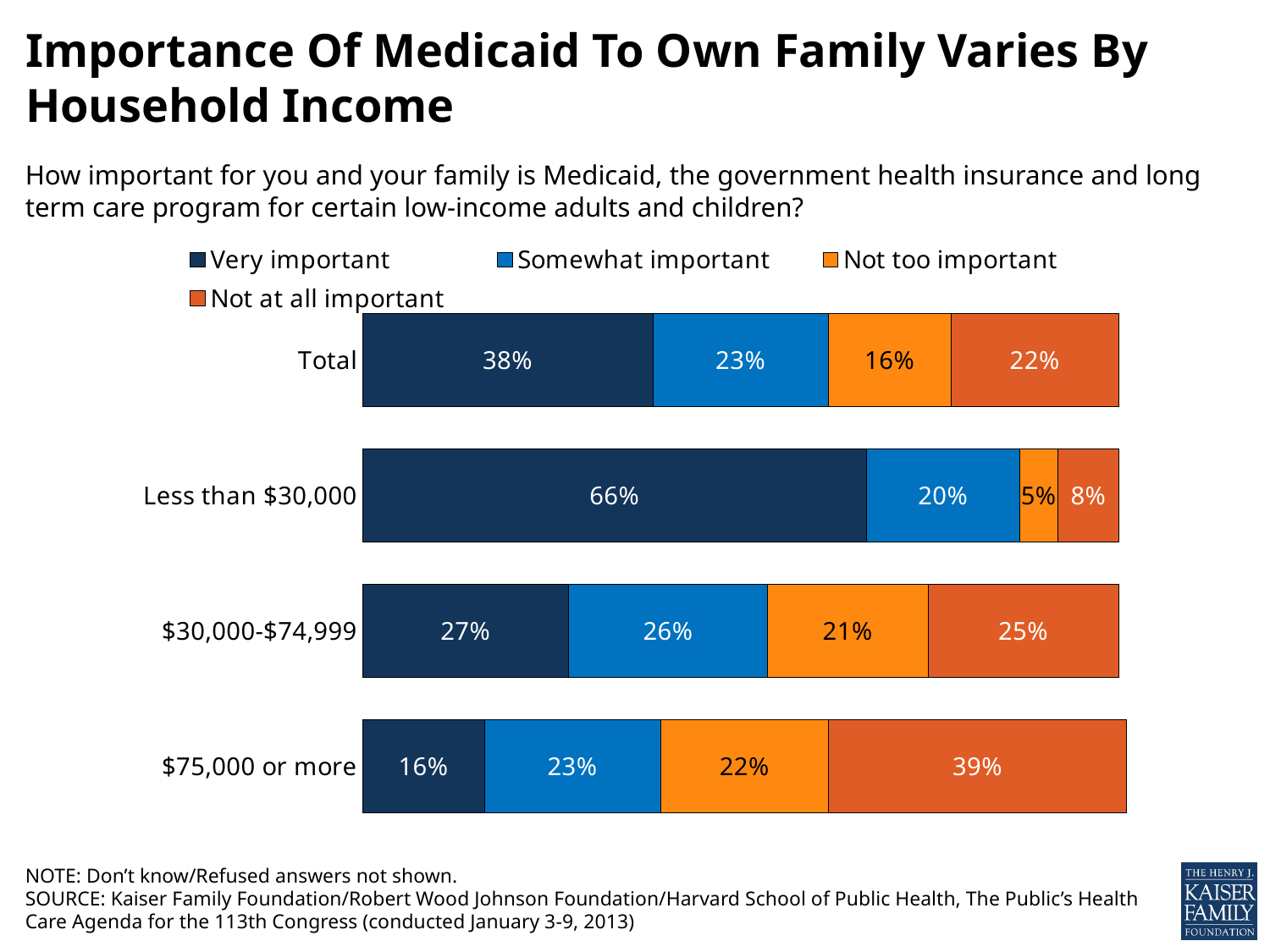
What percentage of those earning $75,000 or more say Medicaid is not at all important? 39% What is the difference between the very important shares for the less than $30,000 group and the $75,000 or more group? 50 percentage points Which is larger: the not at all important share for $75,000 or more, or for $30,000-$74,999? $75,000 or more What percentage of the $30,000-$74,999 group says Medicaid is not too important? 21% How many income categories (bars) are shown in the chart? 4 What kind of chart is shown on the slide? Stacked bar chart Which income group has the lowest share saying Medicaid is not at all important? Less than $30,000 How many series does the legend list? 4 What is the combined share of very important and somewhat important for the less than $30,000 group? 86% Which income group has the highest share saying Medicaid is very important? Less than $30,000 What percentage of the Total group says Medicaid is very important? 38% What percentage of those with household income less than $30,000 say Medicaid is very important? 66%